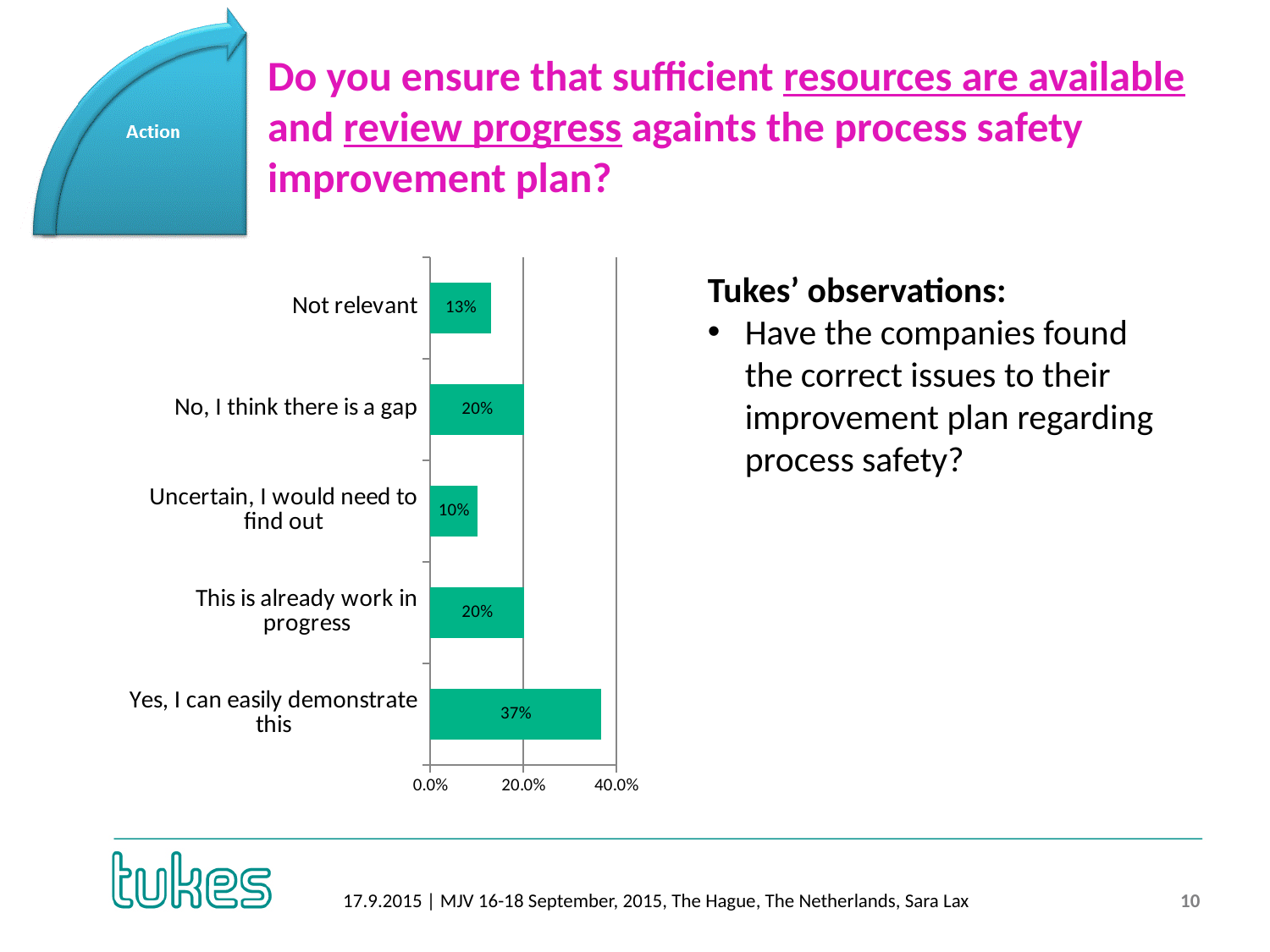
What is the highest value shown on the x axis? 40.0% What is the value for "Not relevant"? 13% What is the value for "Uncertain, I would need to find out"? 10% What kind of chart is shown on the slide? bar chart What is the difference between "Yes, I can easily demonstrate this" and "This is already work in progress"? 17% What is the value for "Yes, I can easily demonstrate this"? 37% Which category has the lowest value? Uncertain, I would need to find out Which category has the highest value? Yes, I can easily demonstrate this How many categories are shown in the chart? 5 Which is larger: "Not relevant" or "Uncertain, I would need to find out"? Not relevant What is the value for "No, I think there is a gap"? 20% Is the value for "Yes, I can easily demonstrate this" greater or less than 20.0%? greater